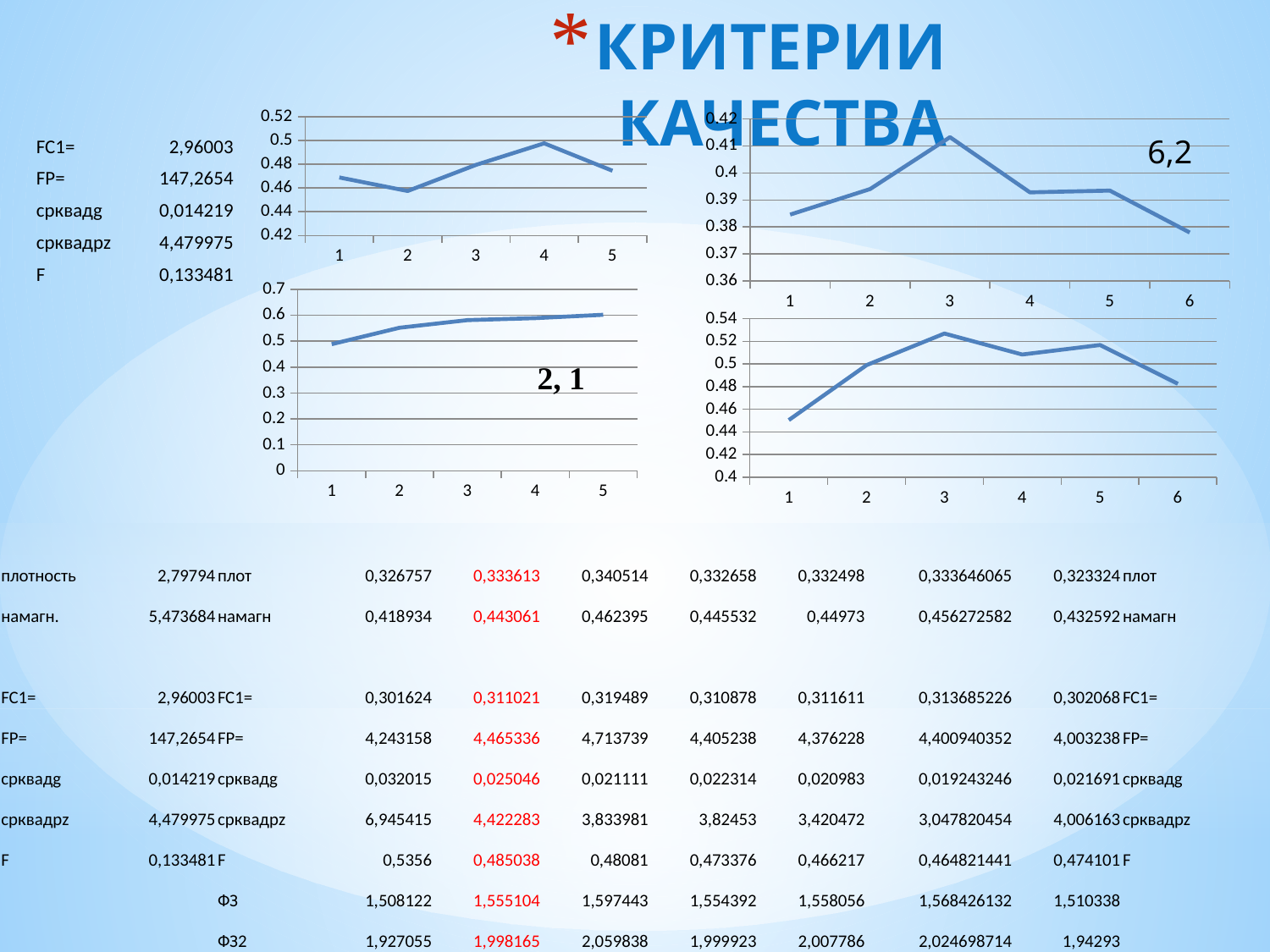
What kind of chart is the top-left chart on the slide? line chart In the top-left chart, at which x-axis category is the value highest? 4 In the bottom-right chart, is the value at category 3 greater or less than 0.5? greater In the bottom-right chart, at which x-axis category is the value lowest? 1 How many points are plotted along the x axis in the top-left chart? 5 In the top-right chart (labelled "6,2"), is the value at category 3 greater or less than 0.4? greater In the bottom-left chart (labelled "2, 1"), is the value at category 5 greater or less than 0.5? greater How many points are plotted along the x axis in the top-right chart (labelled "6,2")? 6 In the top-left chart, at which x-axis category is the value lowest? 2 In the top-right chart (labelled "6,2"), at which x-axis category is the value highest? 3 In the bottom-left chart (labelled "2, 1"), do the values rise or fall from category 1 to category 5? rise